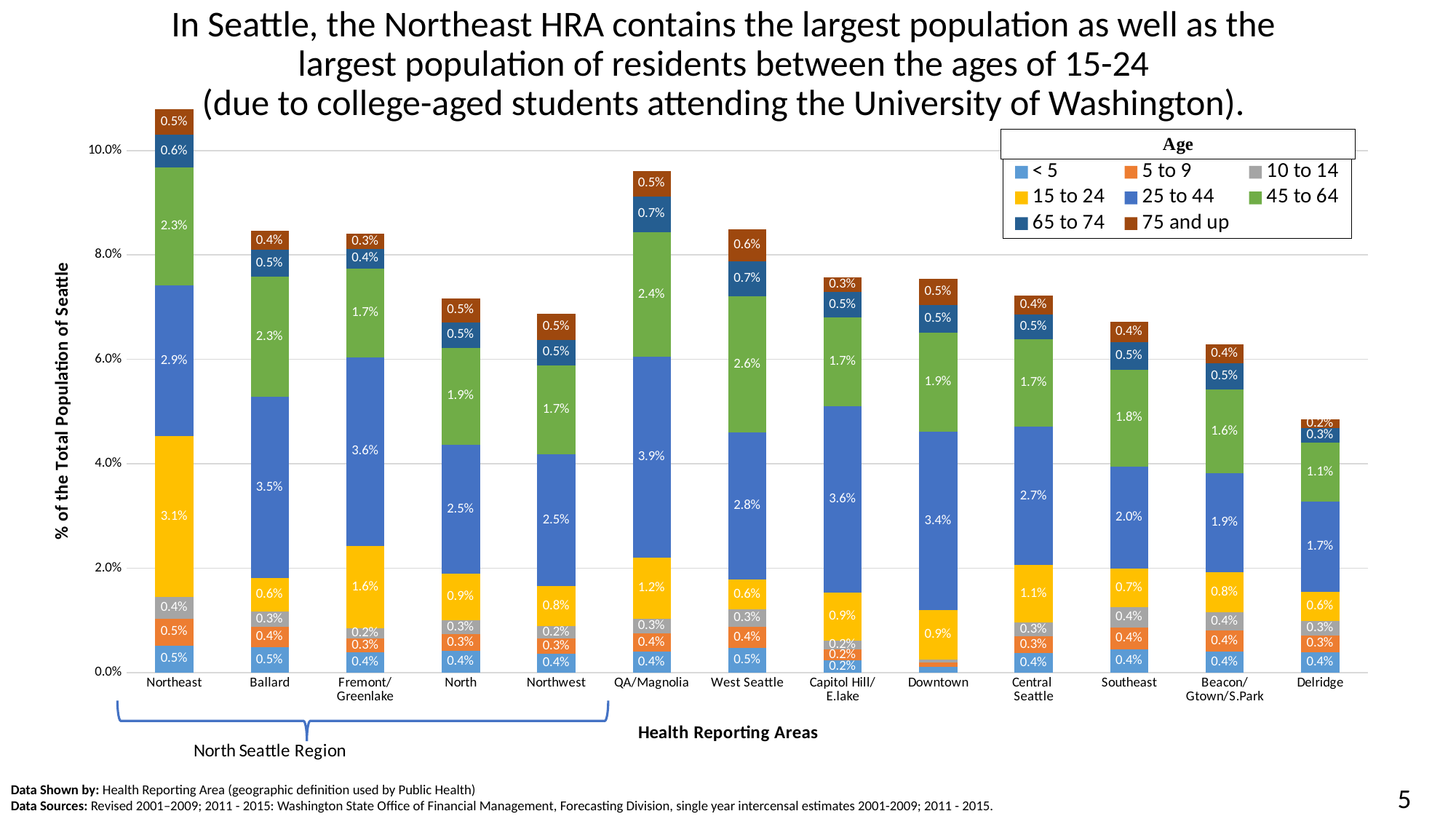
What is the difference between the 45 to 64 segment for West Seattle and for Delridge? 1.5% How many Health Reporting Areas are shown on the x axis? 13 Which Health Reporting Area has the tallest stacked bar overall? Northeast What is the title of the y axis? % of the Total Population of Seattle Which Health Reporting Area has the shortest stacked bar overall? Delridge Is the total height of the Northeast bar greater or less than 10.0%? greater What kind of chart is shown on the slide? Stacked bar chart How many age groups does the legend list? 8 Which has the larger 15 to 24 segment, Northeast or Fremont/Greenlake? Northeast What is the value of the 45 to 64 segment for Southeast? 1.8% What is the value of the 15 to 24 segment for Northeast? 3.1% What is the value of the 25 to 44 segment for QA/Magnolia? 3.9%